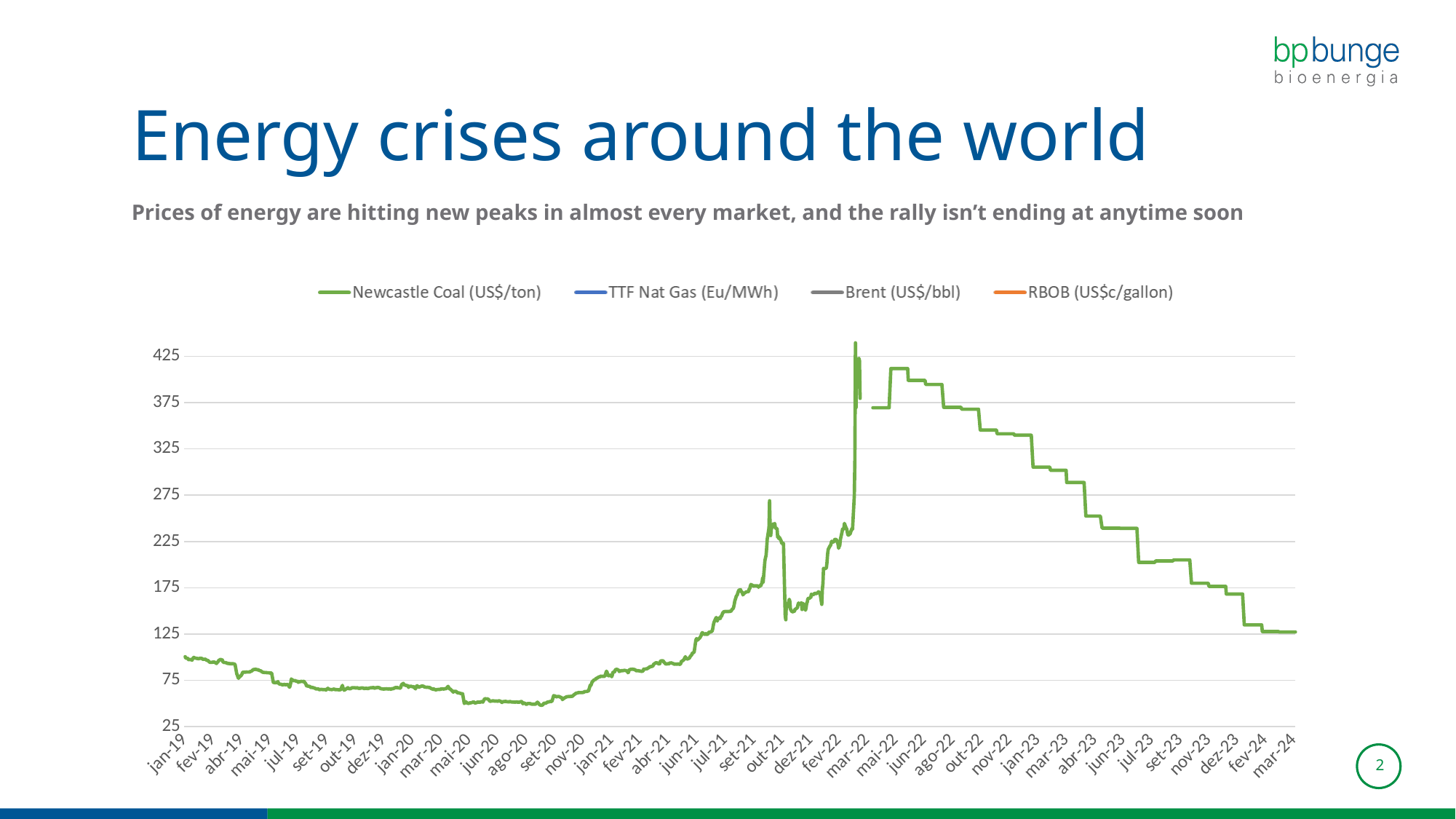
Is the Newcastle Coal value at jul-23 greater or less than 175? greater Is the Newcastle Coal value at jun-22 greater or less than 375? greater What is the title of the slide containing the chart? Energy crises around the world Which is larger, the Newcastle Coal value at jan-19 or at mar-24? mar-24 Which series in the legend is drawn in green? Newcastle Coal (US$/ton) Does the Newcastle Coal line rise or fall between jun-22 and mar-24? fall Does the Newcastle Coal line rise or fall between set-20 and set-21? rise What kind of chart is shown on the slide? line chart Is the Newcastle Coal value at jan-19 greater or less than 75? greater How many series does the legend list? 4